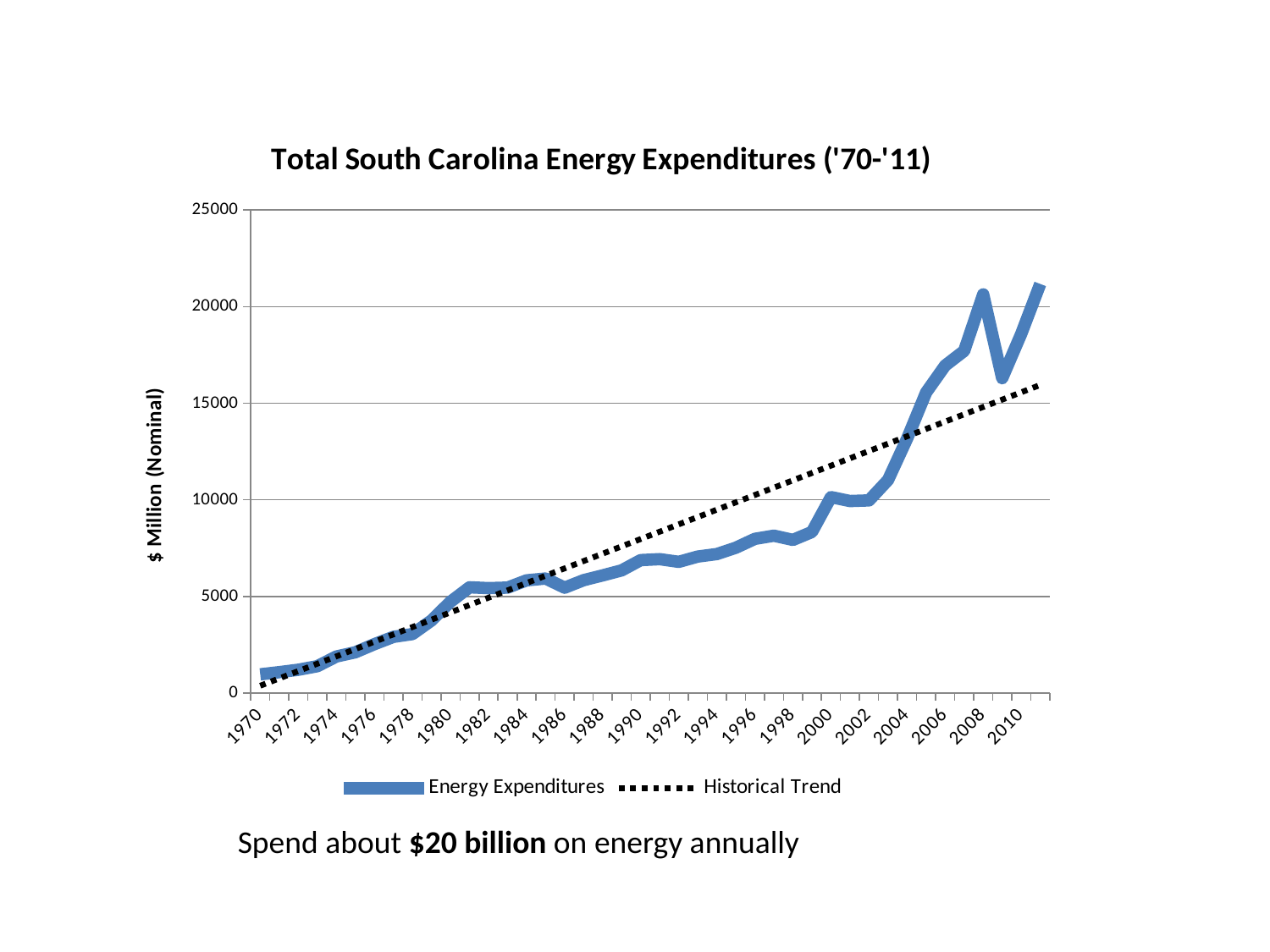
Which year has the lowest Energy Expenditures value? 1970 What is the label on the vertical axis? $ Million (Nominal) Which year has the larger Energy Expenditures value, 1990 or 2000? 2000 How many series does the legend list? 2 Which year has the larger Energy Expenditures value, 2008 or 2009? 2008 What is the title of the chart? Total South Carolina Energy Expenditures ('70-'11) Is the Energy Expenditures value for 2011 greater or less than 20000? greater Is the Energy Expenditures value for 1978 greater or less than 5000? less Is the Energy Expenditures value for 1990 greater or less than 5000? greater What kind of chart is shown on the slide? Line chart Overall, do Energy Expenditures rise or fall from 1970 to 2011? Rise